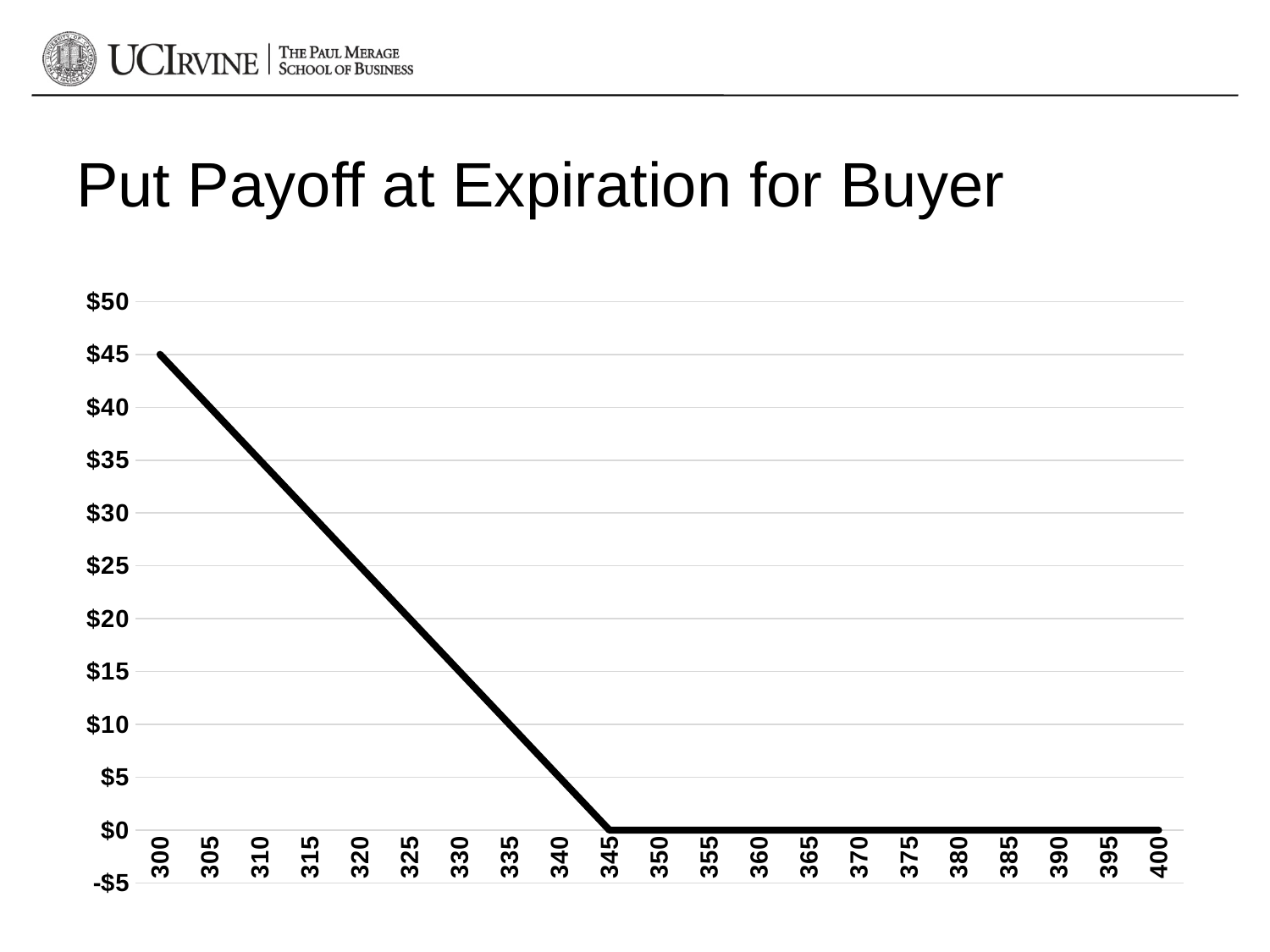
At which price on the x axis is the payoff highest? 300 What is the payoff value at a price of 345? $0 How does the payoff change as the price moves from 300 to 345? it falls How many price points are labelled on the x axis? 21 What is the payoff value at a price of 400? $0 What is the payoff value at a price of 320? $25 What is the payoff value at a price of 300? $45 Is the payoff at a price of 310 greater or less than $30? greater Which has the larger payoff, a price of 300 or a price of 400? 300 Is the payoff at a price of 330 greater or less than $20? less What kind of chart is shown on the slide? line chart What is the title of the chart? Put Payoff at Expiration for Buyer